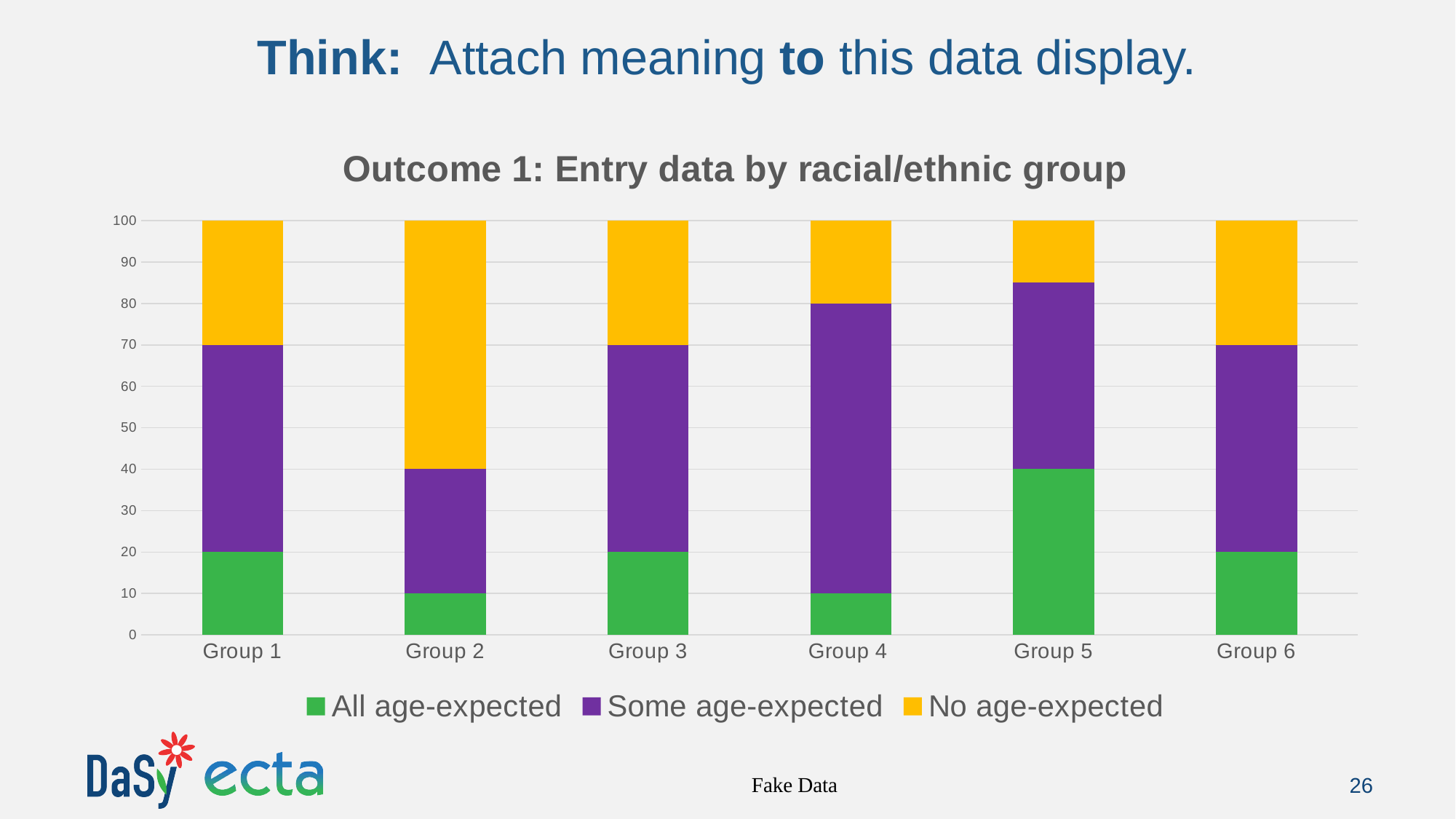
Is the "No age-expected" value for Group 2 greater or less than 50? greater Which group has the highest value for "All age-expected"? Group 5 How many series does the chart's legend list? 3 What is the value of "All age-expected" for Group 2? 10 What is the value of "All age-expected" for Group 1? 20 How many groups are shown on the x axis of the chart? 6 Which group has the largest "Some age-expected" segment? Group 4 Which group has the largest "No age-expected" segment? Group 2 What is the total of the stacked bar for Group 3? 100 What is the title of the chart? Outcome 1: Entry data by racial/ethnic group What type of chart is shown on the slide? Stacked bar chart What is the value of "All age-expected" for Group 5? 40